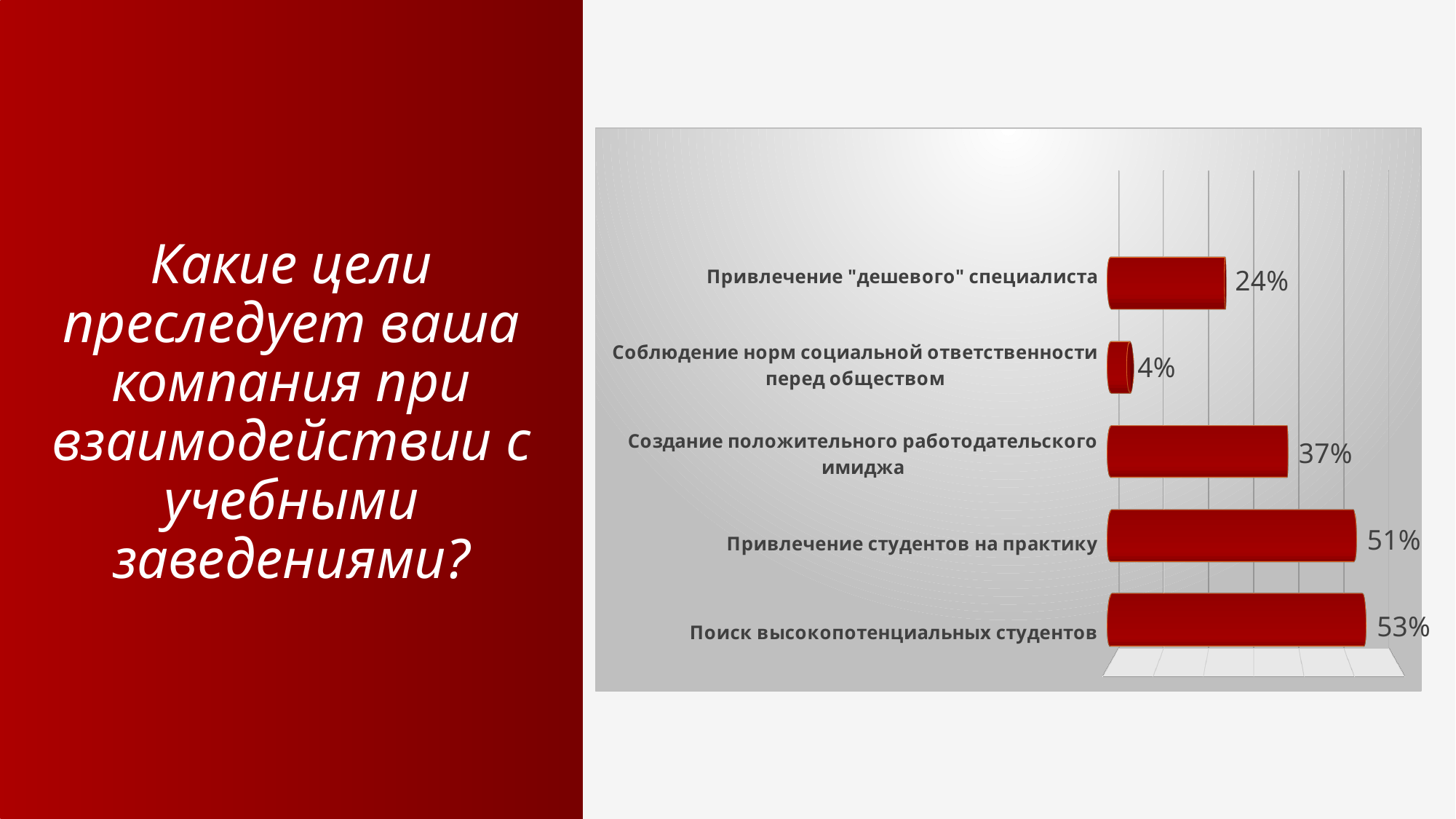
Which category has the highest value? Поиск высокопотенциальных студентов What is the difference between the values for "Поиск высокопотенциальных студентов" and "Создание положительного работодательского имиджа"? 16% What colour are the bars in the chart? Red What is the value for "Создание положительного работодательского имиджа"? 37% What is the value for "Соблюдение норм социальной ответственности перед обществом"? 4% What is the value for "Поиск высокопотенциальных студентов"? 53% What kind of chart is shown on the slide? Bar chart How many categories are shown in the chart? 5 What is the value for "Привлечение студентов на практику"? 51% Which category has the lowest value? Соблюдение норм социальной ответственности перед обществом What is the value for "Привлечение "дешевого" специалиста"? 24% Which is larger: the value for "Привлечение "дешевого" специалиста" or the value for "Создание положительного работодательского имиджа"? Создание положительного работодательского имиджа